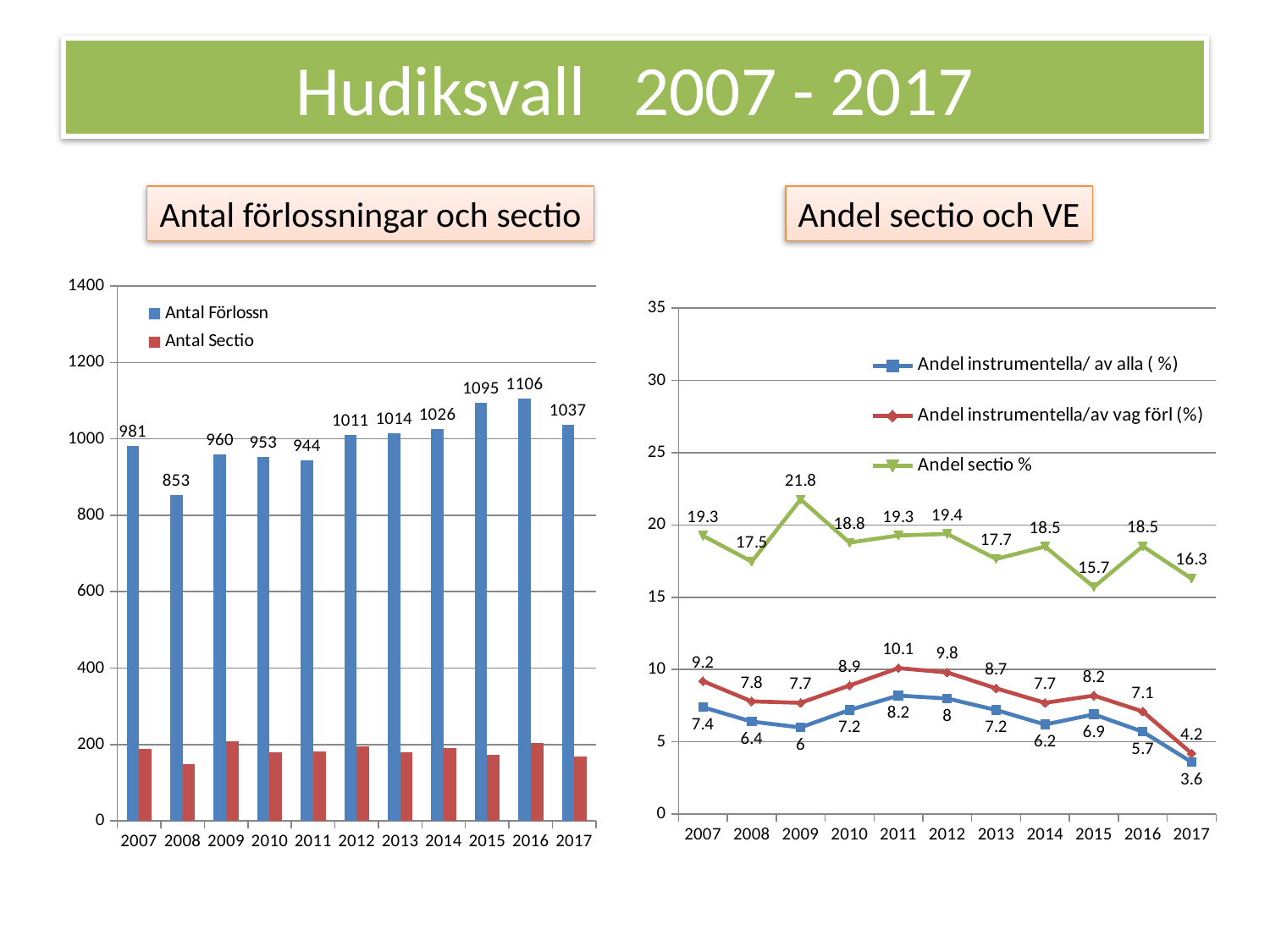
In the chart 'Andel sectio och VE', what is the value of Andel sectio % for 2009? 21.8 In the chart 'Antal förlossningar och sectio', which year has the lowest Antal Förlossn? 2008 In the chart 'Andel sectio och VE', which year has the highest value for Andel instrumentella/av vag förl (%)? 2011 In the chart 'Andel sectio och VE', what is the value of Andel instrumentella/ av alla (%) for 2017? 3.6 In the chart 'Andel sectio och VE', which is larger in 2015: Andel sectio % or Andel instrumentella/av vag förl (%)? Andel sectio % In the chart 'Andel sectio och VE', does Andel instrumentella/ av alla (%) rise or fall from 2015 to 2017? fall In the chart 'Antal förlossningar och sectio', what is the difference between Antal Förlossn in 2016 and 2017? 69 In the chart 'Antal förlossningar och sectio', is the Antal Sectio bar for 2008 greater or less than 200? less What kind of chart is 'Antal förlossningar och sectio'? bar chart In the chart 'Antal förlossningar och sectio', how many series does the legend list? 2 In the chart 'Andel sectio och VE', how many years are plotted on the x axis? 11 In the chart 'Antal förlossningar och sectio', what is the value of Antal Förlossn for 2016? 1106